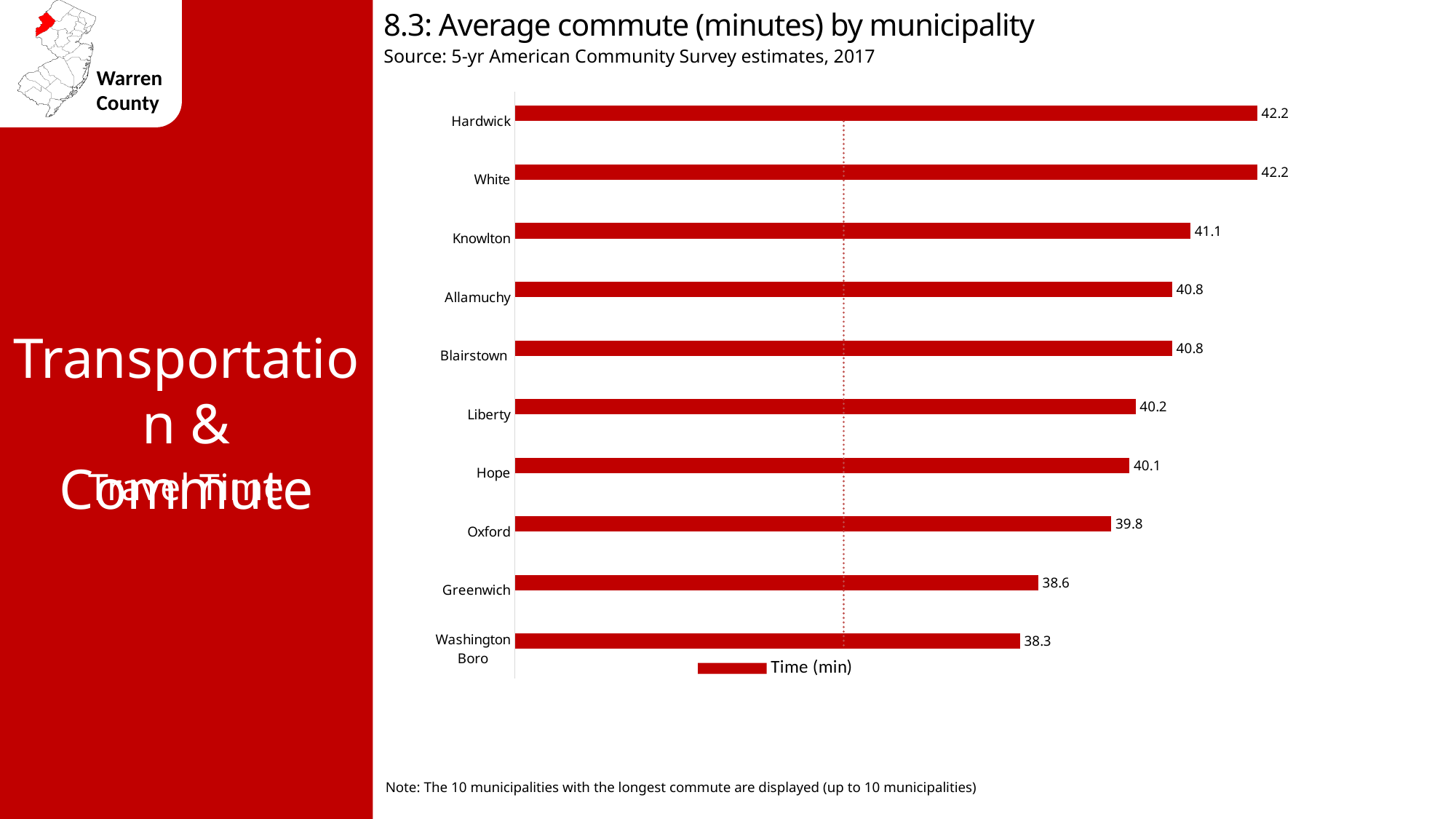
What is the difference in average commute time between Hardwick and Greenwich? 3.6 What is the average commute time for Washington Boro? 38.3 What is the average commute time for Knowlton? 41.1 Which has a longer average commute, Greenwich or Oxford? Oxford Which has a longer average commute, Allamuchy or Hope? Allamuchy How many series does the legend list? 1 Which municipality has the shortest average commute shown on the chart? Washington Boro What kind of chart is shown on the slide? Bar chart What is the name of the series shown in the legend? Time (min) How many municipalities are shown on the chart? 10 What is the difference in average commute time between Knowlton and Oxford? 1.3 What is the average commute time for Liberty? 40.2